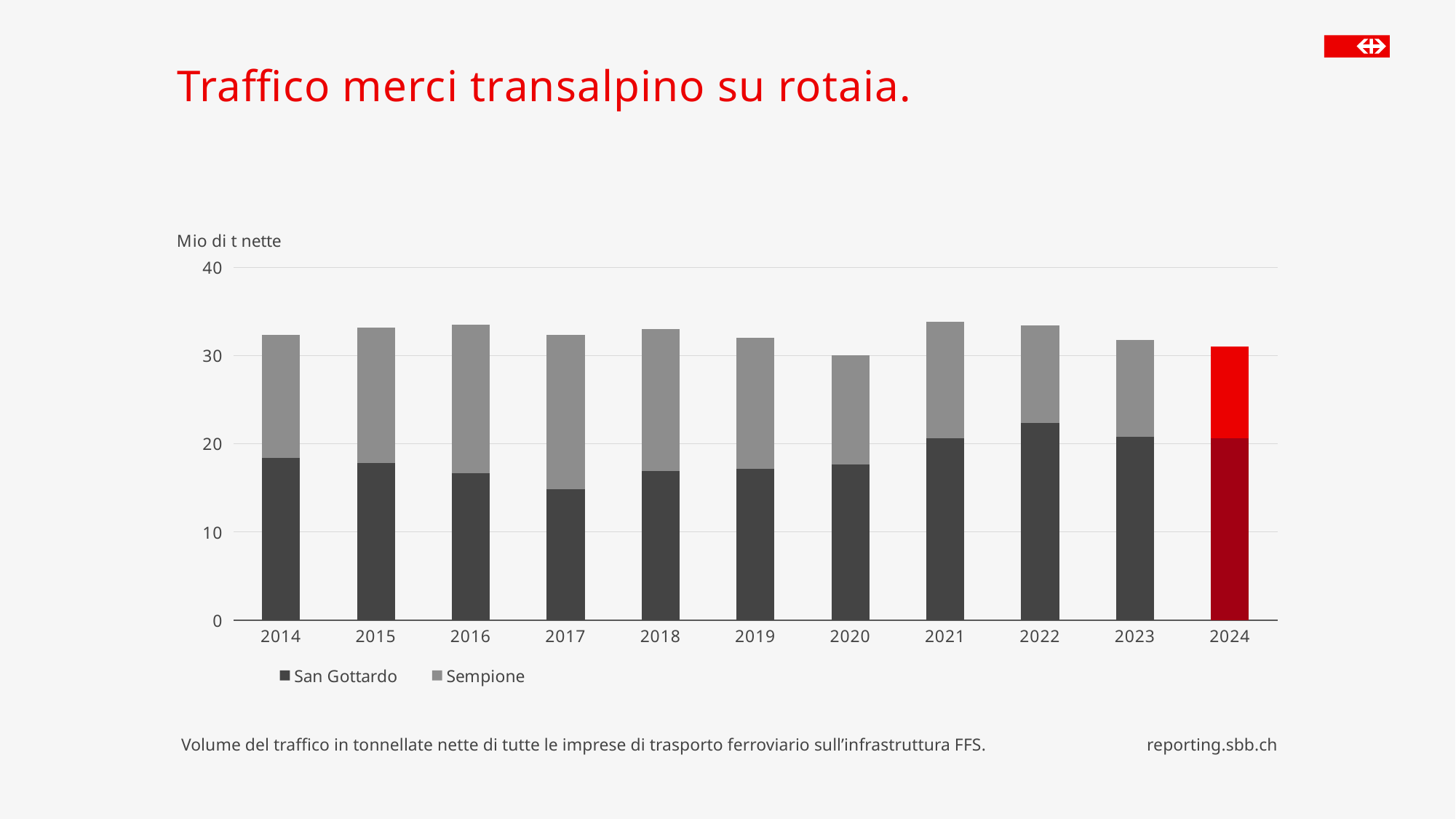
Is the total stacked value for 2021 greater or less than 30? greater In which year is the San Gottardo value highest? 2022 How many series does the legend list? 2 Which is larger, the Sempione value for 2017 or the Sempione value for 2022? 2017 How many years are shown on the x axis of the chart? 11 What kind of chart is shown on the slide? stacked bar chart Does the San Gottardo value rise or fall from 2017 to 2022? rise What unit label is shown above the y axis? Mio di t nette Is the San Gottardo value for 2017 greater or less than 20? less In which year is the San Gottardo value lowest? 2017 Which series are listed in the legend? San Gottardo, Sempione Is the San Gottardo value for 2022 greater or less than 20? greater